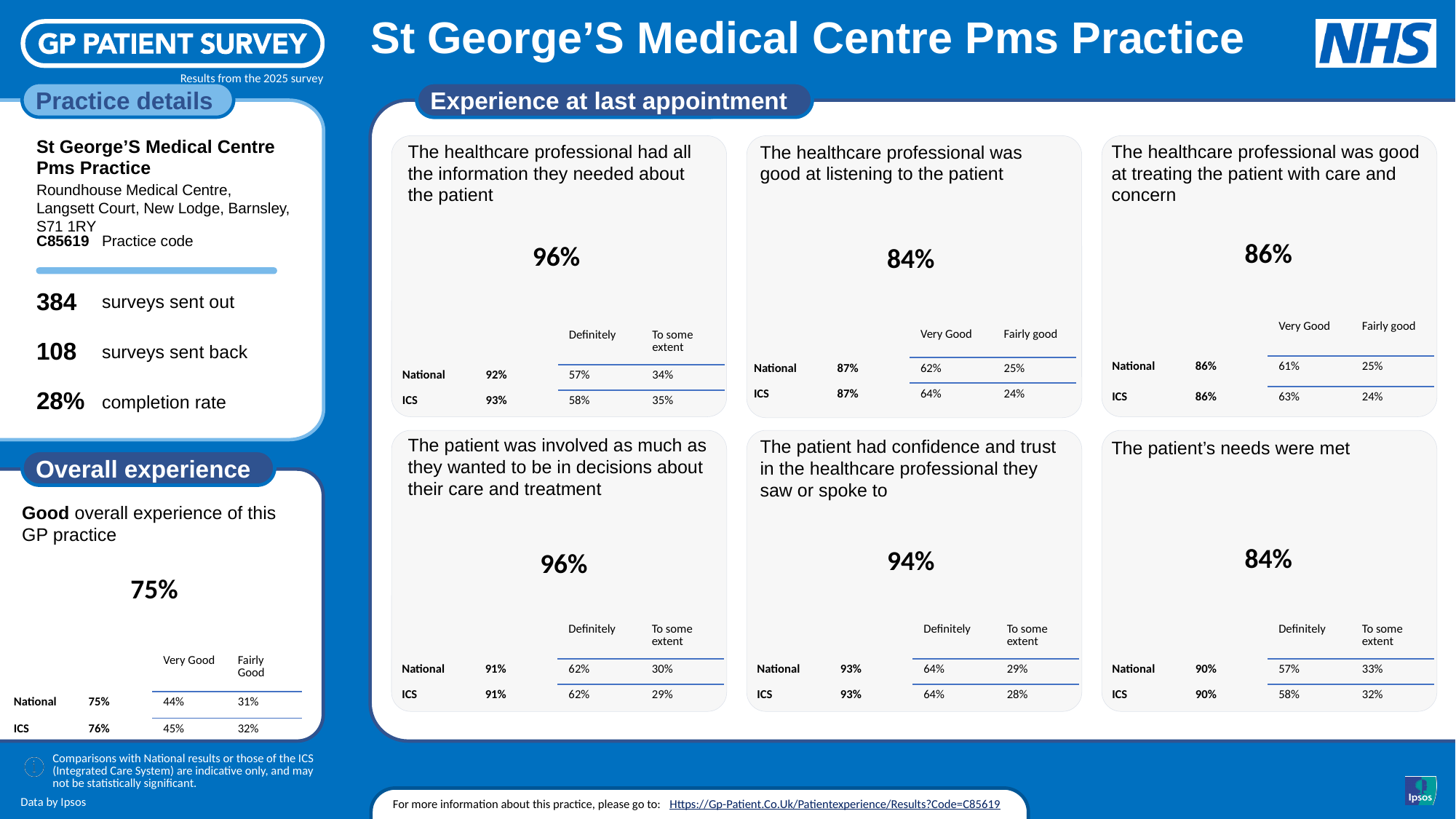
In the 'Experience at last appointment' section, what percentage is shown for 'The healthcare professional had all the information they needed about the patient'? 96% In the panel 'The healthcare professional was good at listening to the patient', how much lower is the practice value (84%) than the National value (87%)? 3 percentage points In the 'Overall experience' panel, what is the ICS 'Very Good' value? 45% In the panel 'The patient had confidence and trust in the healthcare professional they saw or spoke to', what is the ICS 'To some extent' value? 28% In the 'Overall experience' panel, what is the National value for good overall experience? 75% In the panel 'The patient was involved as much as they wanted to be in decisions about their care and treatment', is the practice value (96%) higher or lower than the National value (91%)? higher Among the six 'Experience at last appointment' panels, which statement has the lowest practice percentage? The healthcare professional was good at listening to the patient (84%) and The patient's needs were met (84%) How many statement panels are shown in the 'Experience at last appointment' section? 6 In the 'Overall experience' panel, what percentage of patients reported a good overall experience of this GP practice? 75% In the panel 'The healthcare professional was good at treating the patient with care and concern', what is the difference between the National 'Very Good' value (61%) and the ICS 'Very Good' value (63%)? 2 percentage points In the panel 'The patient's needs were met', what is the National value? 90% In the 'Experience at last appointment' section, what percentage is shown for 'The healthcare professional was good at listening to the patient'? 84%